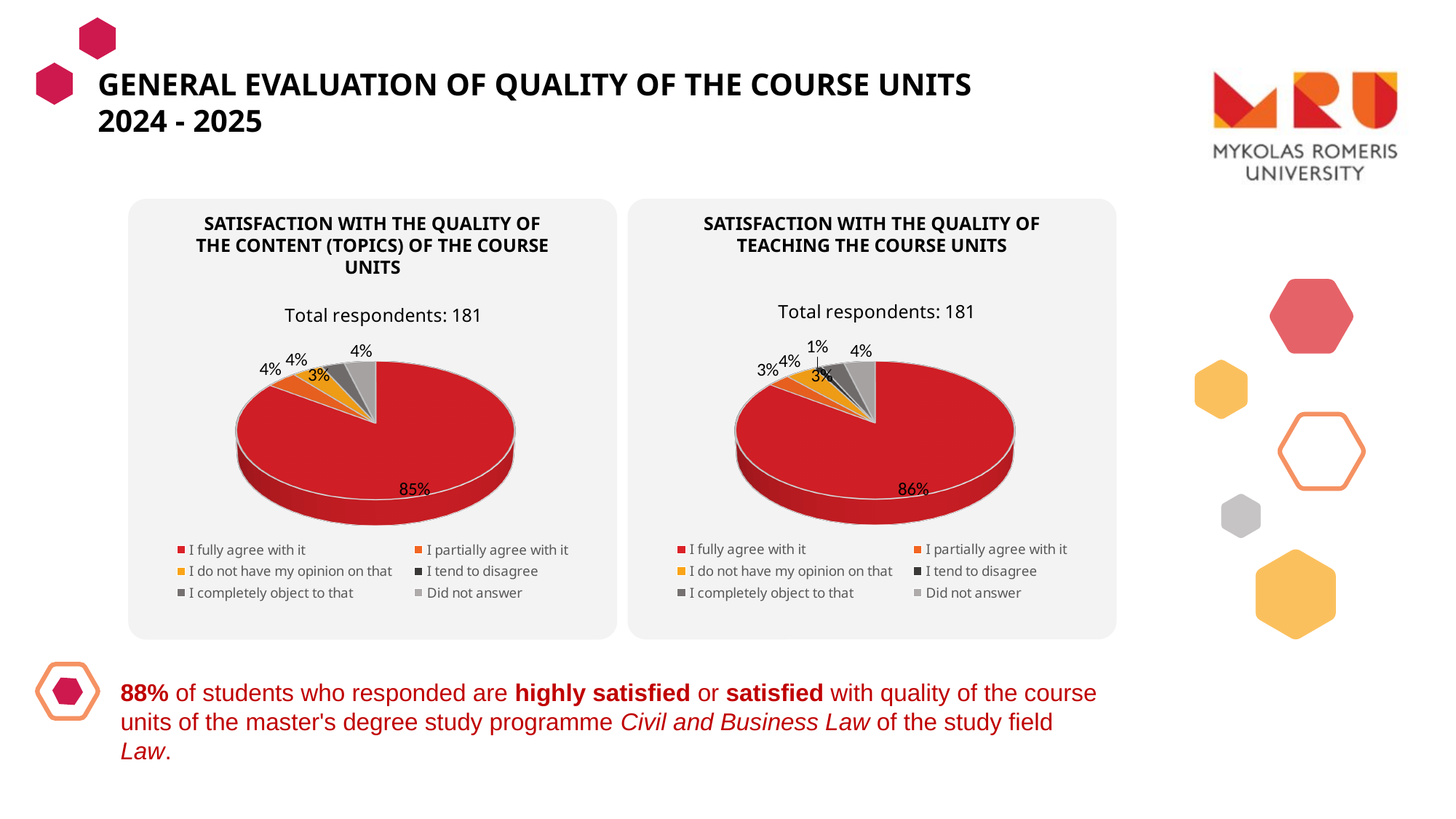
In the chart titled 'Satisfaction with the quality of the content (topics) of the course units', what percentage of respondents did not answer? 4% What is the difference between the 'I fully agree with it' share in the right chart and in the left chart? 1% What type of chart is used in the left panel? pie chart How many total respondents are reported for the left chart? 181 Which chart has the larger share for 'I fully agree with it', the left chart or the right chart? the right chart In the chart titled 'Satisfaction with the quality of the content (topics) of the course units', what percentage of respondents fully agree with it? 85% In the chart titled 'Satisfaction with the quality of teaching the course units', what percentage of respondents did not answer? 4% In the right chart, which response category has the smallest share? I tend to disagree In the left chart, which response category has the largest share? I fully agree with it How many entries does the legend of the right chart list? 6 In the chart titled 'Satisfaction with the quality of teaching the course units', what percentage of respondents fully agree with it? 86% In the chart titled 'Satisfaction with the quality of teaching the course units', what percentage of respondents tend to disagree? 1%